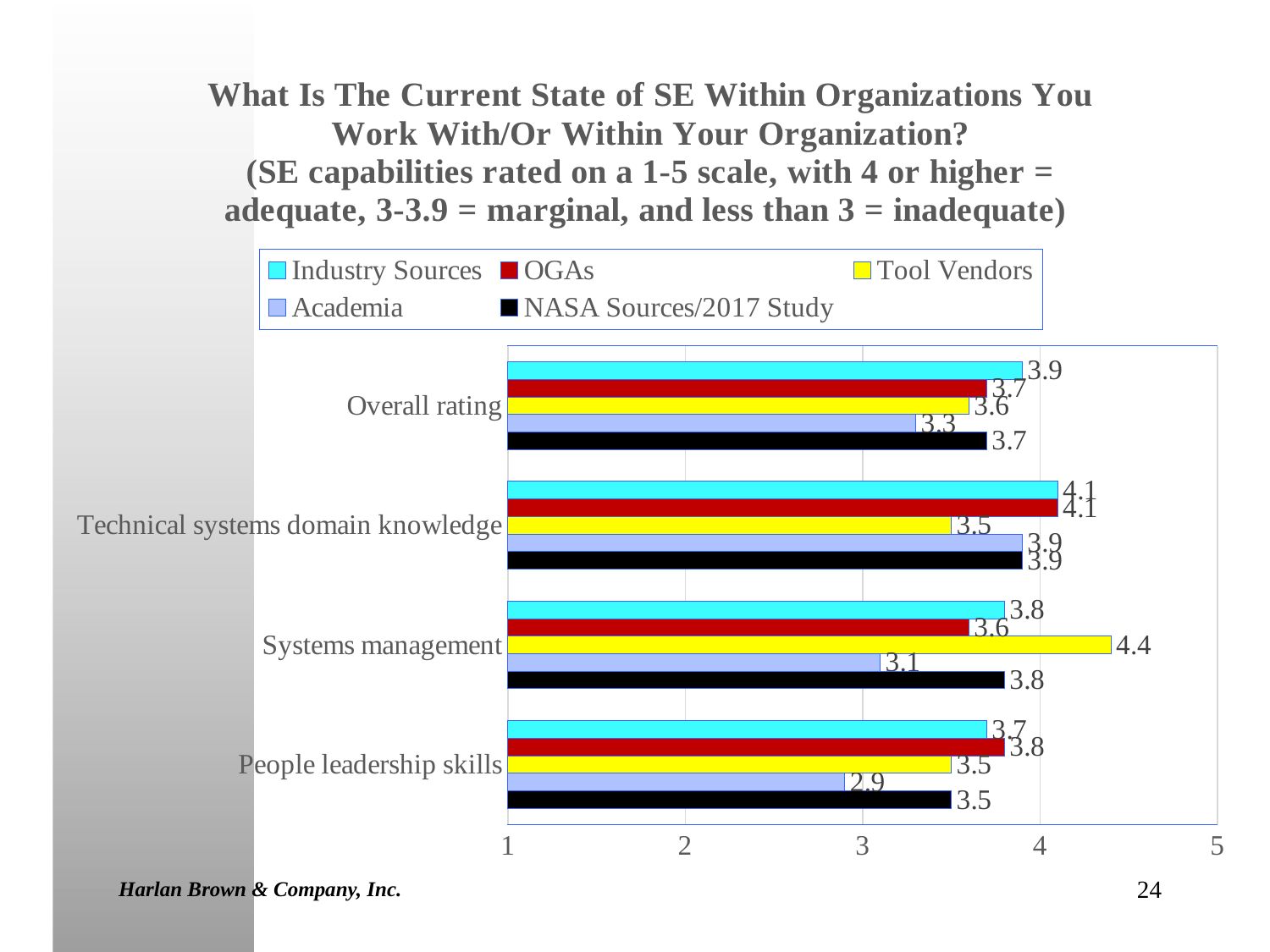
What is the difference between the Tool Vendors and Academia values for Systems management? 1.3 What is the NASA Sources/2017 Study value for Technical systems domain knowledge? 3.9 Which is larger for People leadership skills, the OGAs value or the Tool Vendors value? OGAs Is the Academia value for People leadership skills greater or less than 3? less What is the Industry Sources value for Overall rating? 3.9 How many categories are shown on the chart? 4 What kind of chart is shown on the slide? Bar chart What is the Academia value for People leadership skills? 2.9 How many series does the legend list? 5 What is the Tool Vendors value for Systems management? 4.4 Which series has the lowest value for Overall rating? Academia Which series has the highest value for Systems management? Tool Vendors